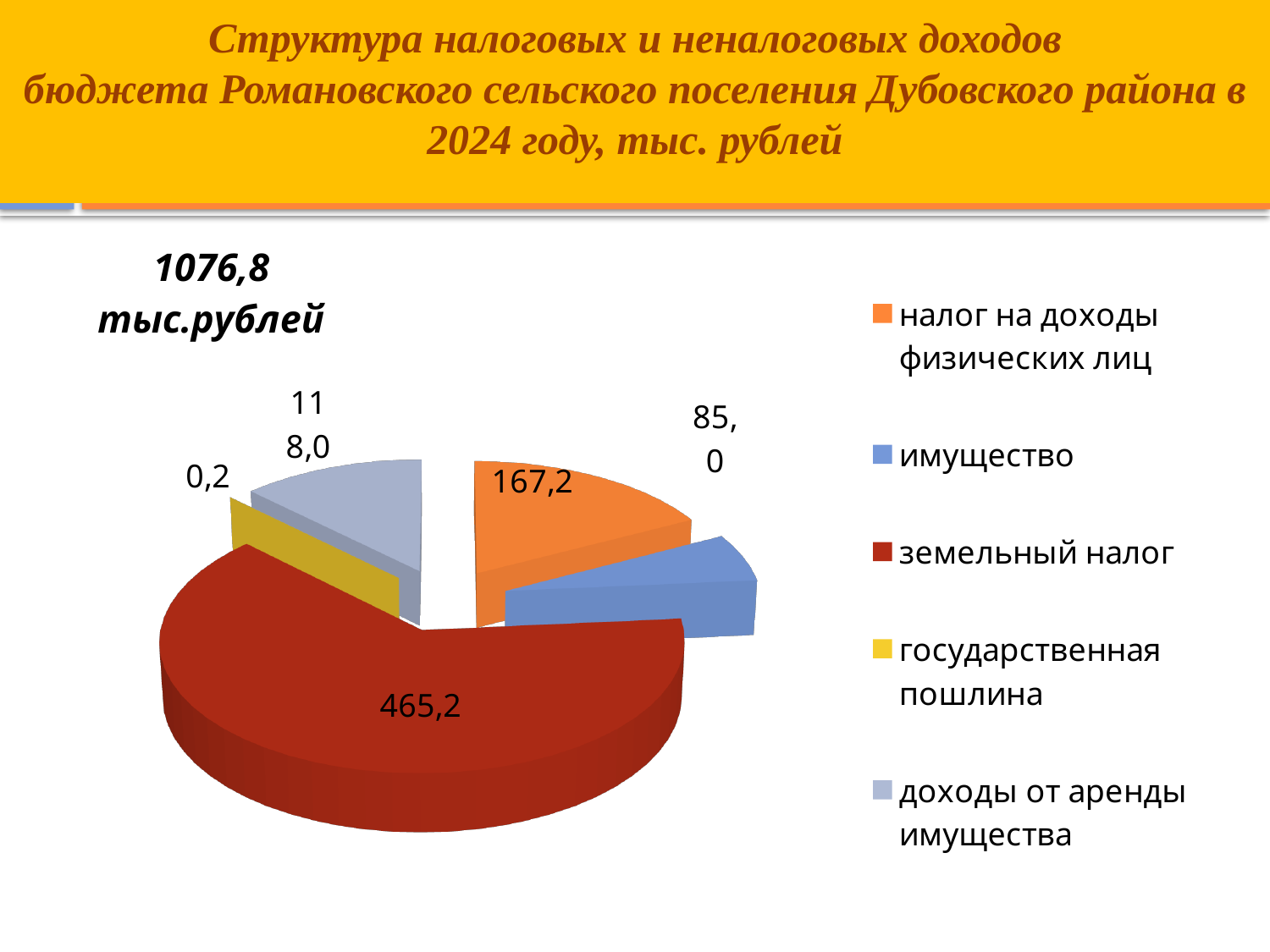
What is the value for земельный налог? 465,2 What is the value for имущество? 85,0 What is the difference between the values for земельный налог and налог на доходы физических лиц? 298,0 How many slices does the pie chart have? 5 What kind of chart is shown on the slide? pie chart How many entries does the legend list? 5 Which is larger, the value for налог на доходы физических лиц or the value for имущество? налог на доходы физических лиц Which category has the largest slice of the pie? земельный налог What is the value for государственная пошлина? 0,2 Which category has the smallest slice of the pie? государственная пошлина What colour is the slice for земельный налог? red What is the value for налог на доходы физических лиц? 167,2